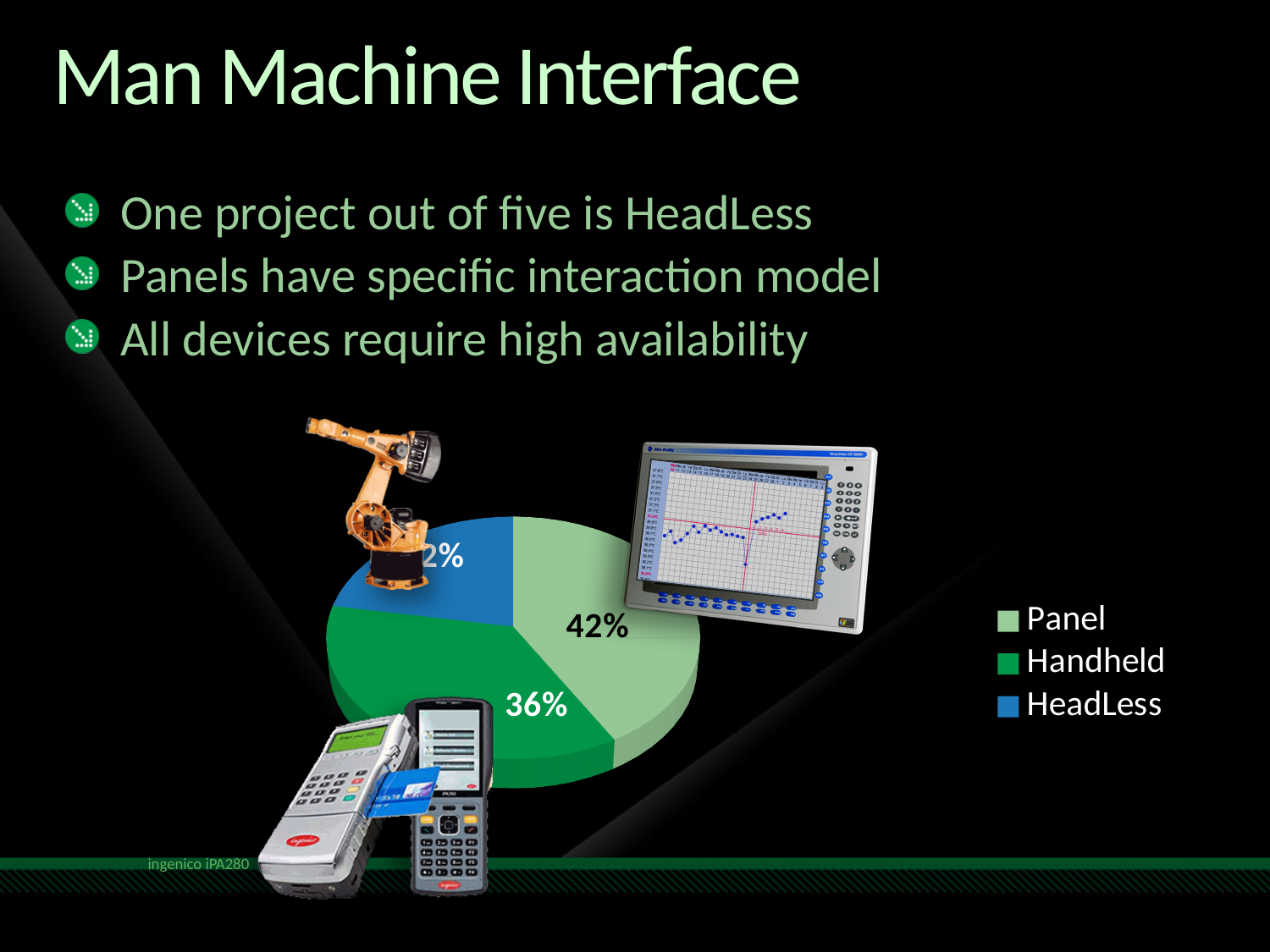
How many slices does the pie chart have? 3 Which category has the largest slice in the pie chart? Panel What share of the pie does the Panel slice take? 42% Which legend entry is shown in blue? HeadLess How many entries does the chart legend list? 3 Which category has the smallest slice in the pie chart? HeadLess What is the difference in percentage points between the Panel slice and the Handheld slice? 6% Which slice is larger, Handheld or HeadLess? Handheld What percentage of the pie chart does the Panel slice represent? 42% Which slice is larger, Panel or Handheld? Panel What kind of chart is shown on the slide? pie chart What percentage of the pie chart does the Handheld slice represent? 36%